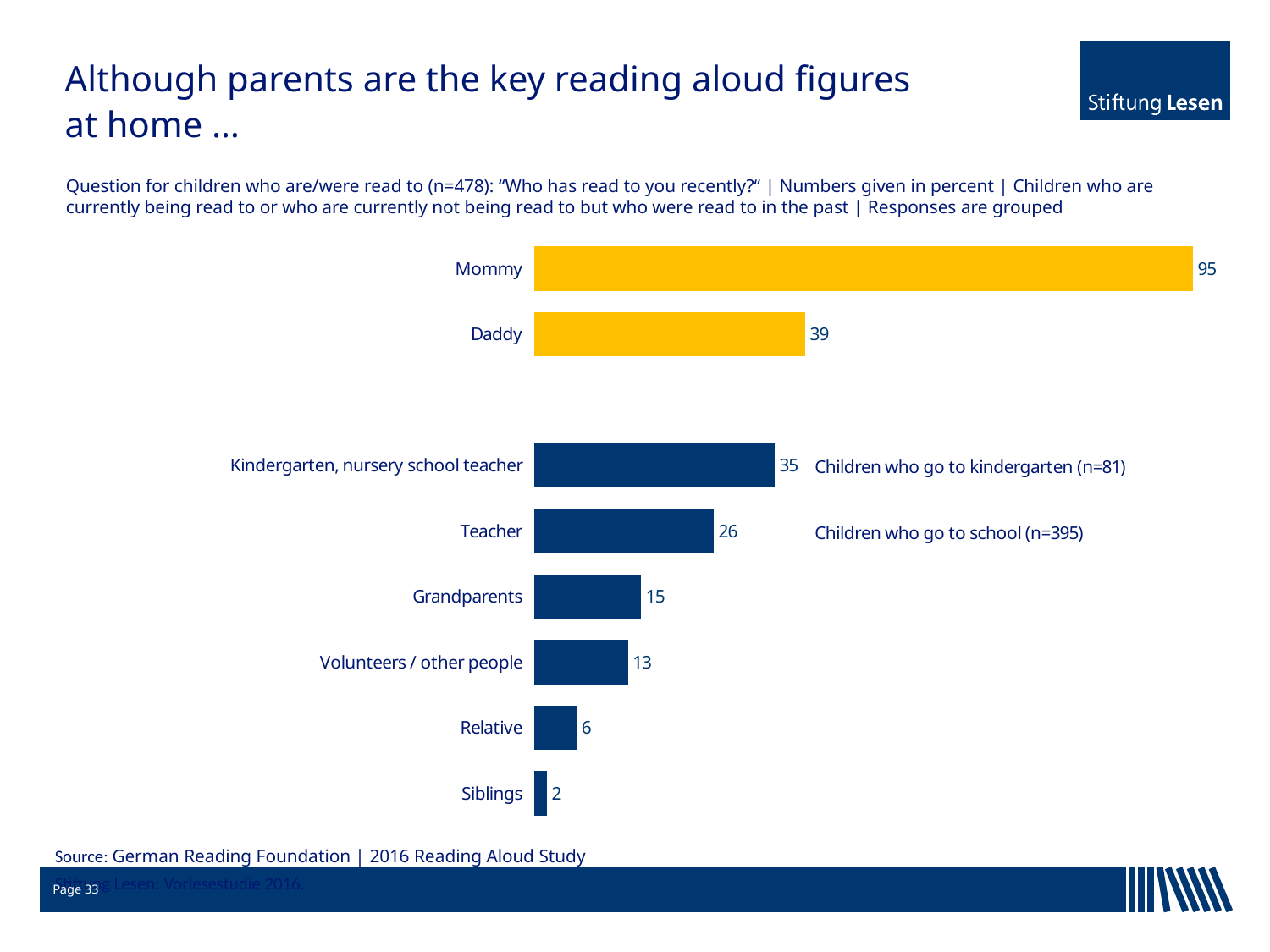
What is the value for Grandparents? 15 Which is larger, the value for Grandparents or the value for Relative? Grandparents Which category has the highest value? Mommy What is the difference between the values for Mommy and Daddy? 56 What is the difference between the values for Teacher and Volunteers / other people? 13 What is the value for Kindergarten, nursery school teacher? 35 What is the value for Mommy? 95 What kind of chart is shown on the slide? Bar chart How many categories are shown in the chart? 9 What is the value for Daddy? 39 What is the value for Siblings? 2 Which category has the lowest value? Siblings